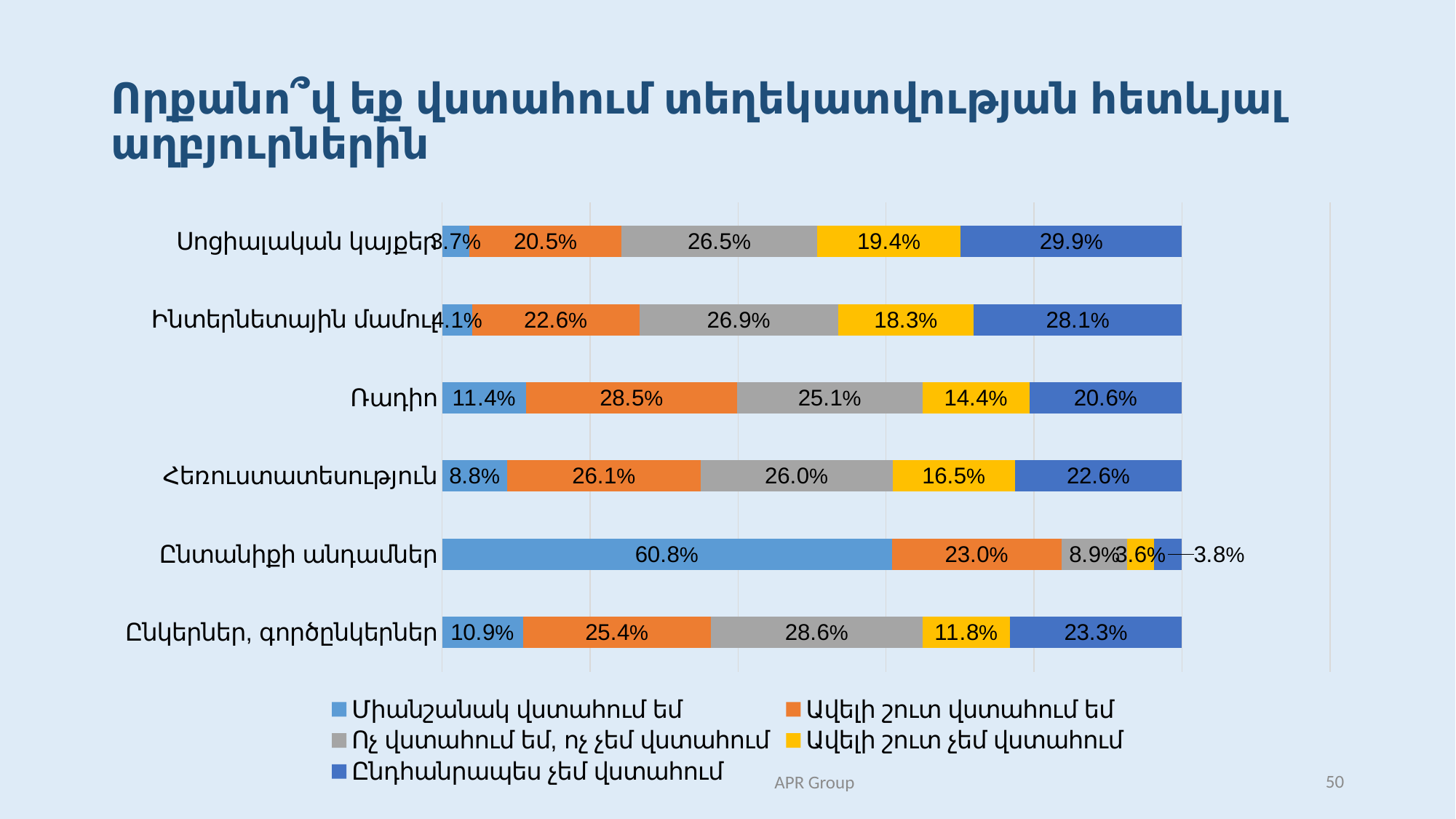
Which category has the highest value for 'Միանշանակ վստահում եմ'? Ընտանիքի անդամներ What is the value of 'Միանշանակ վստահում եմ' for 'Ընտանիքի անդամներ'? 60.8% What is the value of 'Ավելի շուտ վստահում եմ' for 'Ռադիո'? 28.5% Which is larger: the 'Ավելի շուտ վստահում եմ' value for 'Հեռուստատեսություն' or for 'Ինտերնետային մամուլ'? Հեռուստատեսություն What is the value of 'Ավելի շուտ չեմ վստահում' for 'Հեռուստատեսություն'? 16.5% What type of chart is shown on the slide? stacked bar chart What is the difference between the 'Ընդհանրապես չեմ վստահում' values for 'Սոցիալական կայքեր' and 'Ռադիո'? 9.3% Which category has the lowest value for 'Ընդհանրապես չեմ վստահում'? Ընտանիքի անդամներ How many series does the legend list? 5 What is the value of 'Ոչ վստահում եմ, ոչ չեմ վստահում' for 'Ընկերներ, գործընկերներ'? 28.6% What is the value of 'Ընդհանրապես չեմ վստահում' for 'Սոցիալական կայքեր'? 29.9% How many categories are shown on the chart? 6